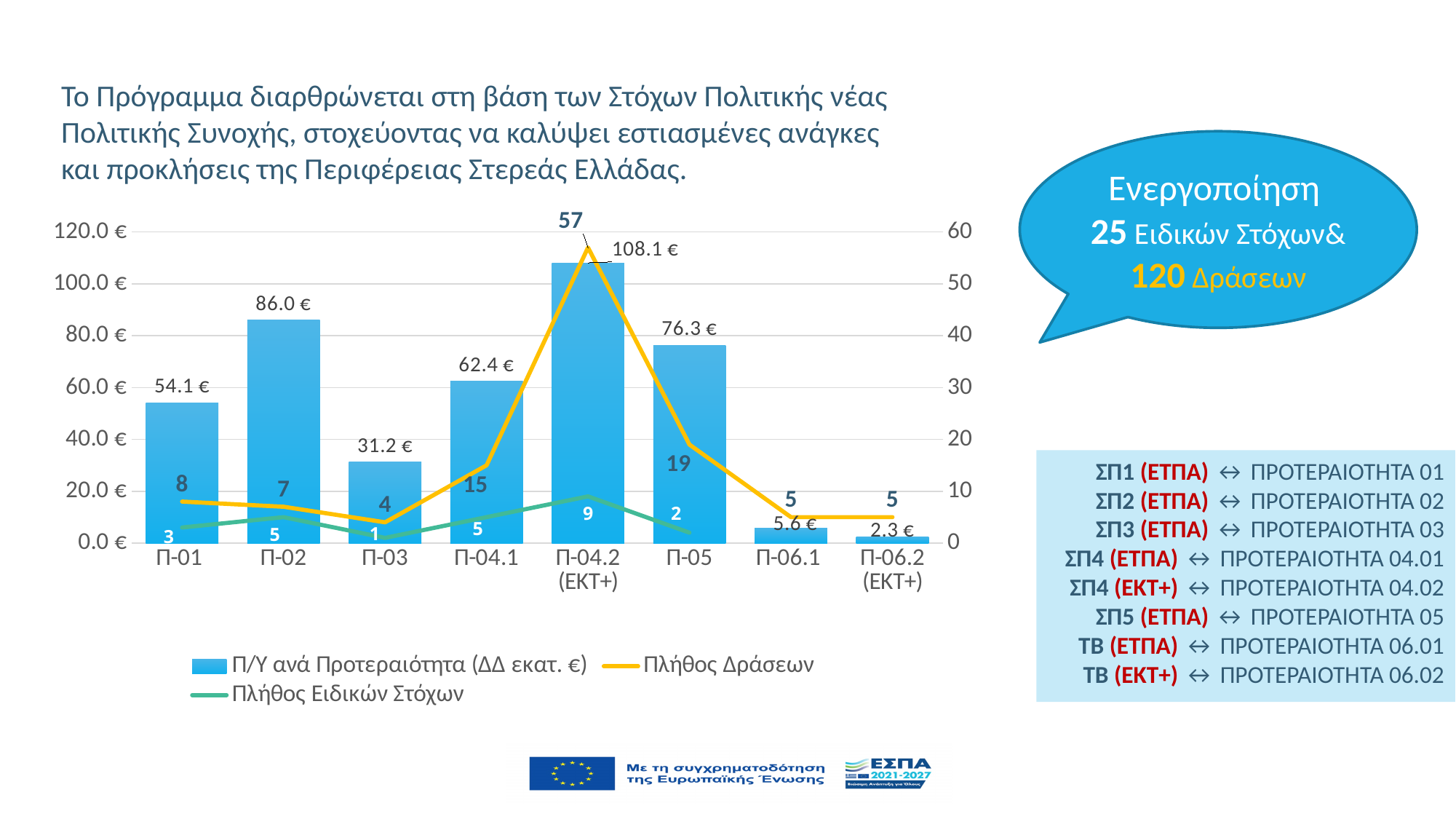
Which priority has the lowest budget (Π/Υ ανά Προτεραιότητα)? Π-06.2 (ΕΚΤ+) What is the value of Πλήθος Δράσεων for Π-05? 19 What is the budget (Π/Υ ανά Προτεραιότητα) for Π-02? 86.0 € How many series does the legend list? 3 What is the value of Πλήθος Ειδικών Στόχων for Π-04.2 (ΕΚΤ+)? 9 How many priorities (categories) are shown on the x axis? 8 Which series is drawn with the yellow line? Πλήθος Δράσεων What is the difference in budget between Π-02 and Π-01? 31.9 € What is the budget (Π/Υ ανά Προτεραιότητα) for Π-04.2 (ΕΚΤ+)? 108.1 € Which priority has the highest budget (Π/Υ ανά Προτεραιότητα)? Π-04.2 (ΕΚΤ+) Which has the larger Πλήθος Δράσεων value, Π-04.1 or Π-05? Π-05 What kind of chart is shown on the slide? Combined bar and line chart